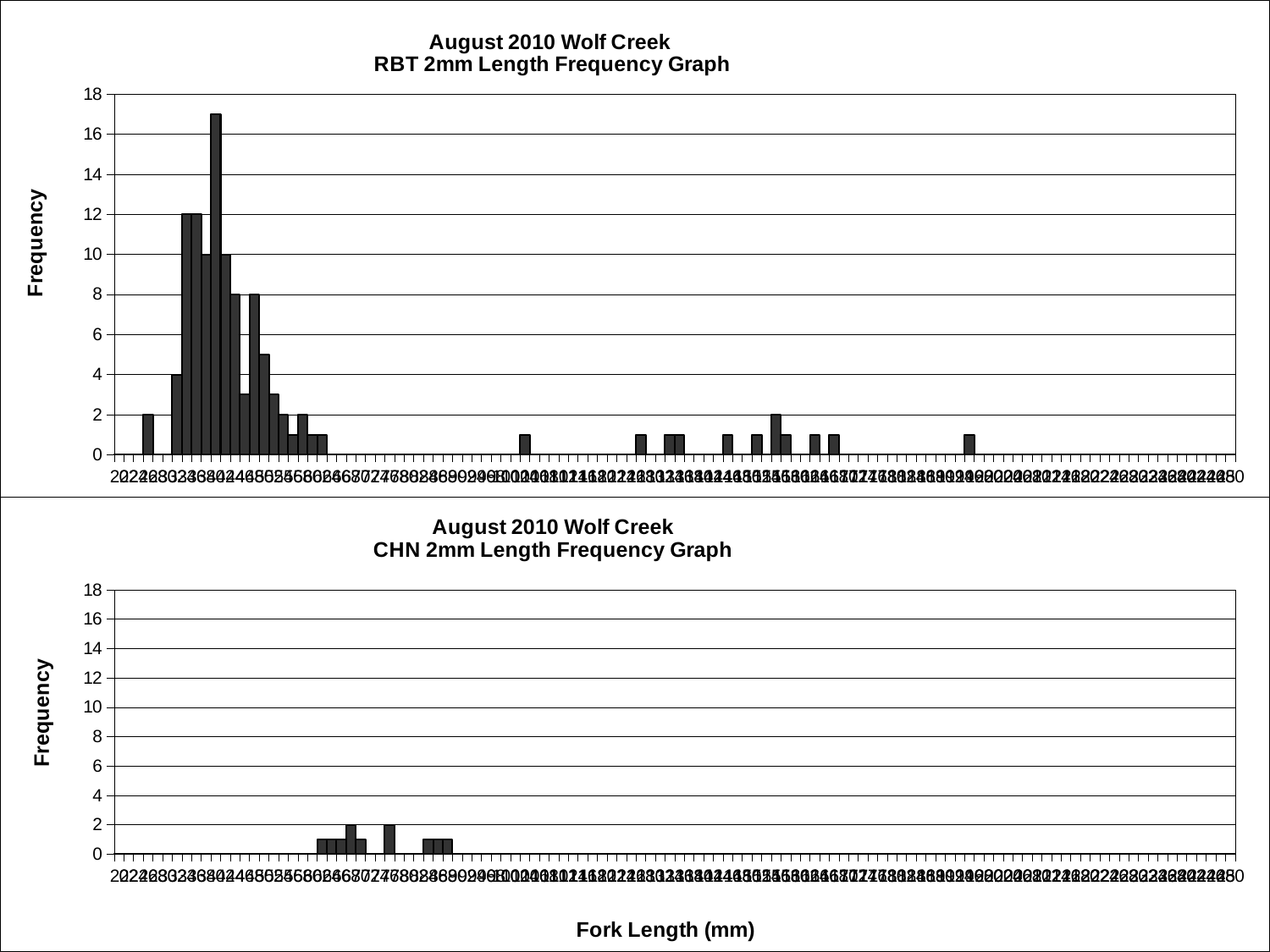
Which chart has the taller tallest bar, the top RBT chart or the bottom CHN chart? the top RBT chart What type of chart is the top chart, titled "August 2010 Wolf Creek RBT 2mm Length Frequency Graph"? bar chart In the top chart (RBT 2mm Length Frequency Graph), is the tallest bar's value greater or less than 16? greater In the bottom chart (CHN 2mm Length Frequency Graph), is the tallest bar's value greater or less than 4? less In the top chart (RBT 2mm Length Frequency Graph), what is the maximum value shown on the y-axis? 18 What type of chart is the bottom chart, titled "August 2010 Wolf Creek CHN 2mm Length Frequency Graph"? bar chart In the bottom chart (CHN 2mm Length Frequency Graph), what is the maximum value shown on the y-axis? 18 In the bottom chart (CHN 2mm Length Frequency Graph), what is the highest frequency value reached by any bar? 2 What is the y-axis label on the top chart (RBT 2mm Length Frequency Graph)? Frequency What is the x-axis label shown at the bottom of the slide for the bottom chart (CHN 2mm Length Frequency Graph)? Fork Length (mm)